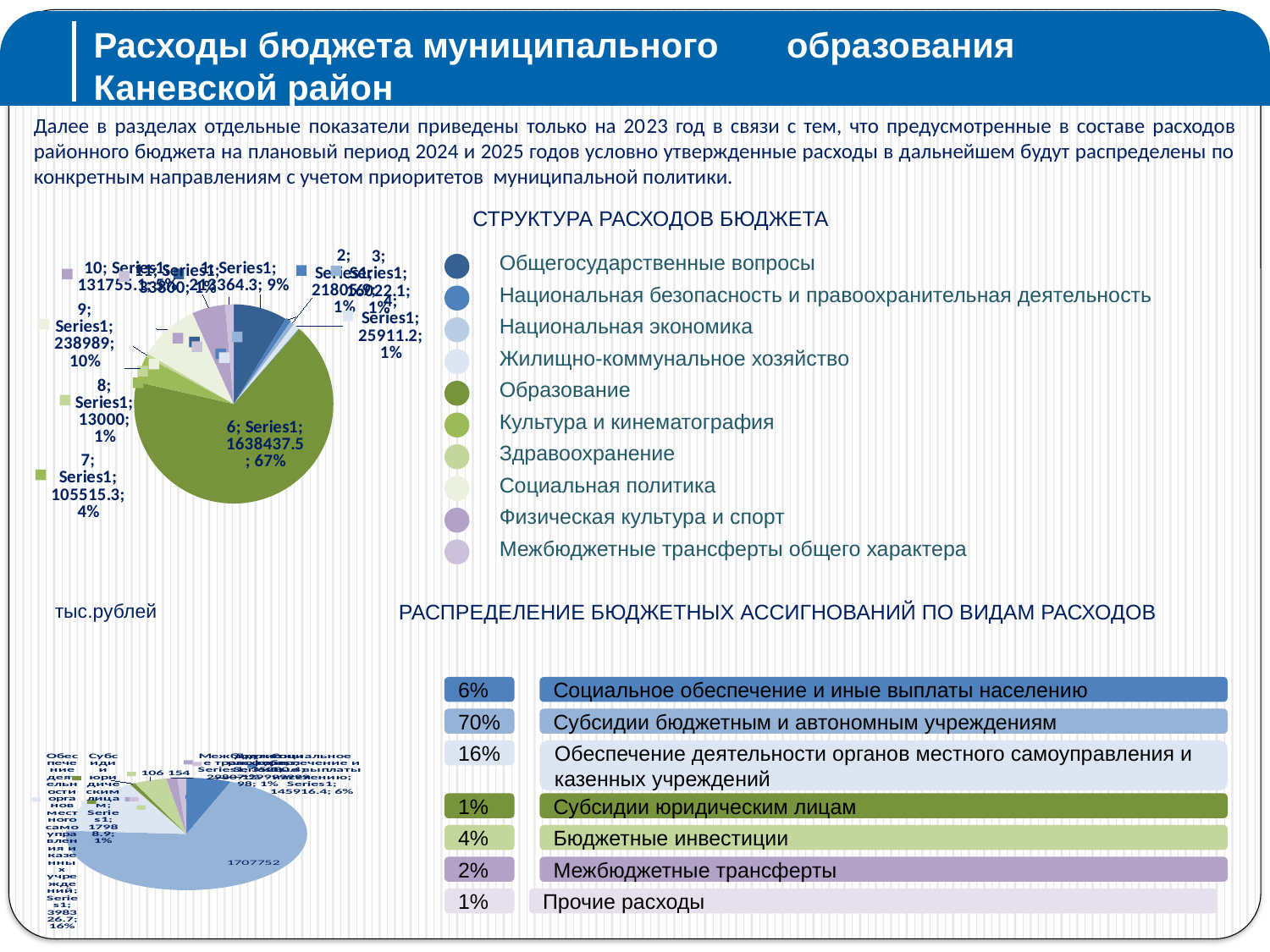
In the 'РАСПРЕДЕЛЕНИЕ БЮДЖЕТНЫХ АССИГНОВАНИЙ ПО ВИДАМ РАСХОДОВ' chart, which has the larger share: 'Бюджетные инвестиции' or 'Межбюджетные трансферты'? Бюджетные инвестиции In the 'РАСПРЕДЕЛЕНИЕ БЮДЖЕТНЫХ АССИГНОВАНИЙ ПО ВИДАМ РАСХОДОВ' chart, which category has the largest share? Субсидии бюджетным и автономным учреждениям In the 'РАСПРЕДЕЛЕНИЕ БЮДЖЕТНЫХ АССИГНОВАНИЙ ПО ВИДАМ РАСХОДОВ' chart, how many percentage points larger is the share of 'Субсидии бюджетным и автономным учреждениям' than that of 'Обеспечение деятельности органов местного самоуправления и казенных учреждений'? 54 How many categories are listed for the 'РАСПРЕДЕЛЕНИЕ БЮДЖЕТНЫХ АССИГНОВАНИЙ ПО ВИДАМ РАСХОДОВ' chart? 7 In the 'РАСПРЕДЕЛЕНИЕ БЮДЖЕТНЫХ АССИГНОВАНИЙ ПО ВИДАМ РАСХОДОВ' chart, what share is shown for 'Социальное обеспечение и иные выплаты населению'? 6% In the 'РАСПРЕДЕЛЕНИЕ БЮДЖЕТНЫХ АССИГНОВАНИЙ ПО ВИДАМ РАСХОДОВ' chart, what share is shown for 'Субсидии бюджетным и автономным учреждениям'? 70% In the 'СТРУКТУРА РАСХОДОВ БЮДЖЕТА' chart, what value is printed on the largest slice (labelled 6)? 1638437.5 In the 'СТРУКТУРА РАСХОДОВ БЮДЖЕТА' chart, what value is printed for the slice labelled 7? 105515.3 What kind of chart is used for the 'СТРУКТУРА РАСХОДОВ БЮДЖЕТА' chart? pie chart How many categories does the legend of the 'СТРУКТУРА РАСХОДОВ БЮДЖЕТА' chart list? 10 In the 'СТРУКТУРА РАСХОДОВ БЮДЖЕТА' chart, what share of the pie does the largest slice (labelled 6) take? 67%